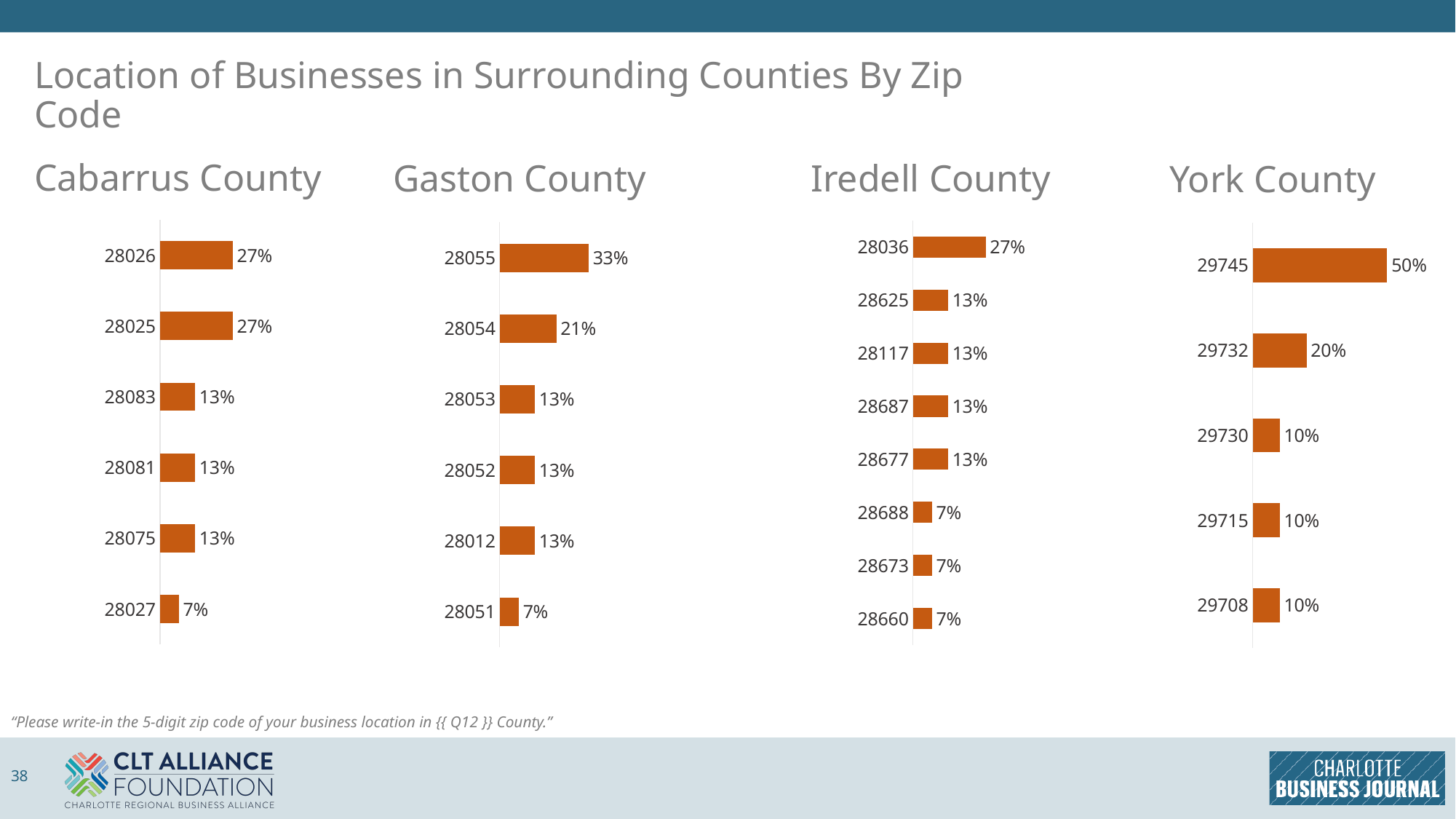
In the York County chart, how many zip codes are shown? 5 In the York County chart, what is the value for zip code 29745? 50% In the Iredell County chart, what is the value for zip code 28036? 27% In the Iredell County chart, how many zip codes are shown? 8 In the Cabarrus County chart, what is the value for zip code 28083? 13% In the Gaston County chart, which zip code has the highest value? 28055 In the Gaston County chart, what is the value for zip code 28051? 7% In the Gaston County chart, what is the difference between the values for 28055 and 28054? 12% In the York County chart, which is larger, the value for 29732 or the value for 29730? 29732 How many county charts are shown on the slide? 4 What kind of chart is the Iredell County chart? Bar chart In the Cabarrus County chart, which zip code has the lowest value? 28027